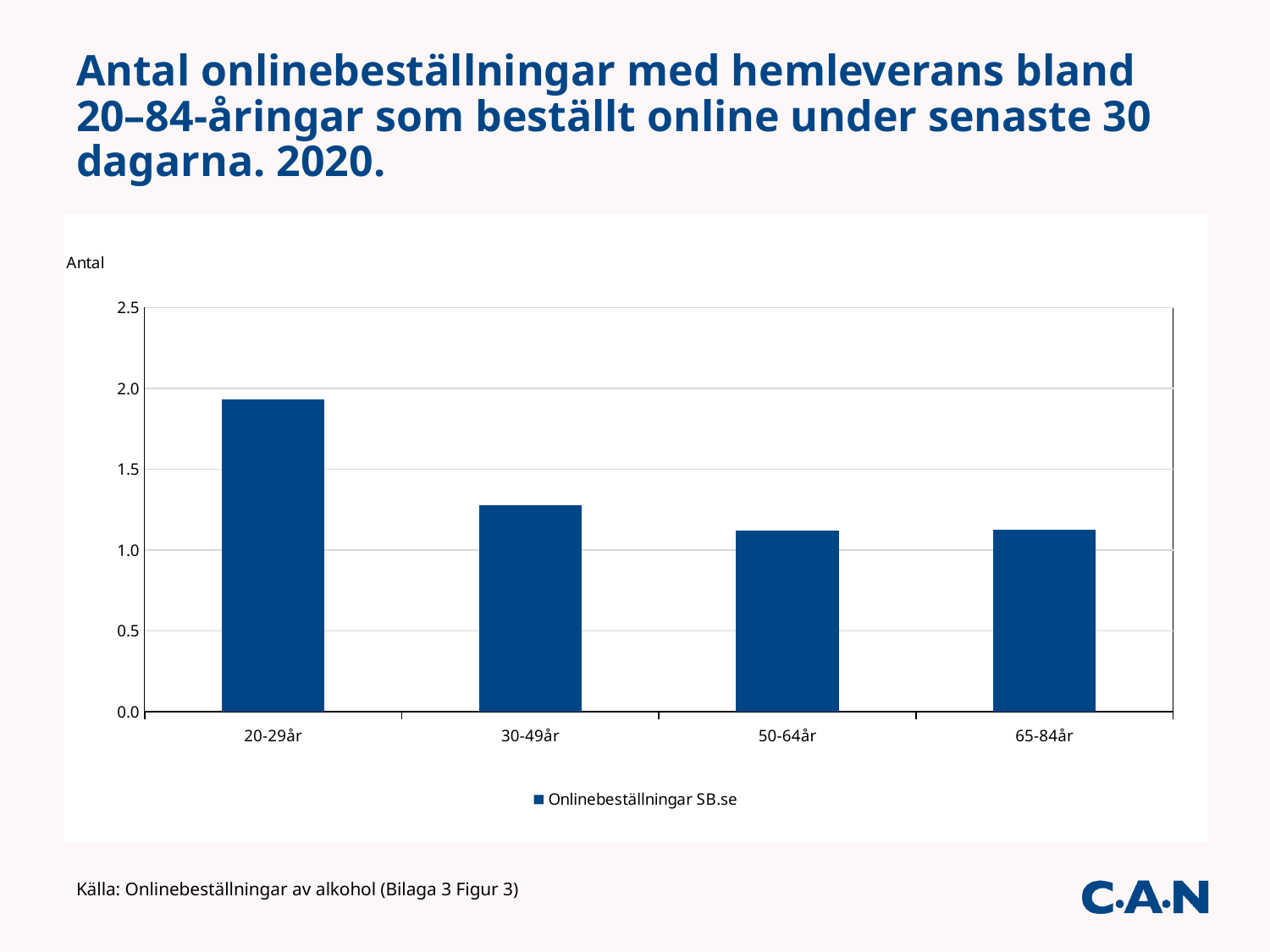
Which is larger, the value for 20-29år or the value for 30-49år? 20-29år How many age-group categories are shown on the x axis? 4 What kind of chart is shown on the slide? bar chart What is the series name shown in the legend? Onlinebeställningar SB.se Is the value for 50-64år greater or less than 1.0? greater How many series does the legend list? 1 Is the value for 20-29år greater or less than 1.5? greater Is the value for 30-49år greater or less than 1.5? less Which is larger, the value for 30-49år or the value for 50-64år? 30-49år Which age group has the highest number of online orders? 20-29år Do the values rise or fall from 20-29år to 50-64år? fall